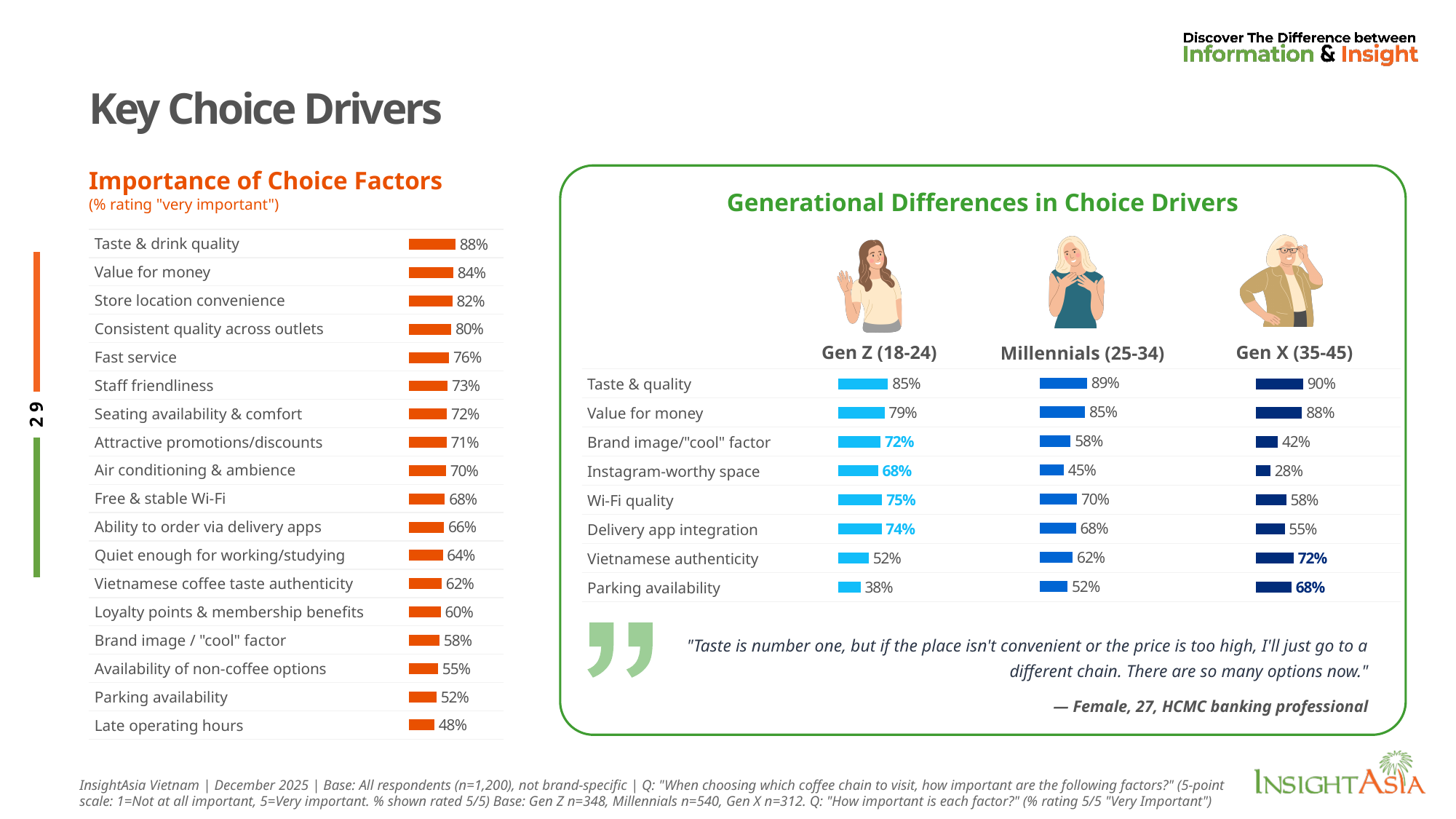
In the "Generational Differences in Choice Drivers" chart, which generation has the highest value for Parking availability? Gen X (35-45) How many factors are listed in the "Importance of Choice Factors" chart? 18 What kind of chart is the "Importance of Choice Factors" chart? Bar chart In the "Importance of Choice Factors" chart, what percentage rated Taste & drink quality as very important? 88% In the "Generational Differences in Choice Drivers" chart, what is the difference between Gen Z and Gen X for Brand image/"cool" factor? 30% In the "Importance of Choice Factors" chart, which is larger: Fast service or Staff friendliness? Fast service In the "Generational Differences in Choice Drivers" chart, what is the Millennials (25-34) value for Vietnamese authenticity? 62% In the "Generational Differences in Choice Drivers" chart, what is the Gen Z (18-24) value for Instagram-worthy space? 68% How many generational groups are shown in the "Generational Differences in Choice Drivers" chart? 3 In the "Importance of Choice Factors" chart, what is the difference between Value for money and Parking availability? 32% In the "Importance of Choice Factors" chart, which factor has the lowest percentage? Late operating hours In the "Generational Differences in Choice Drivers" chart, how many choice factors are listed? 8